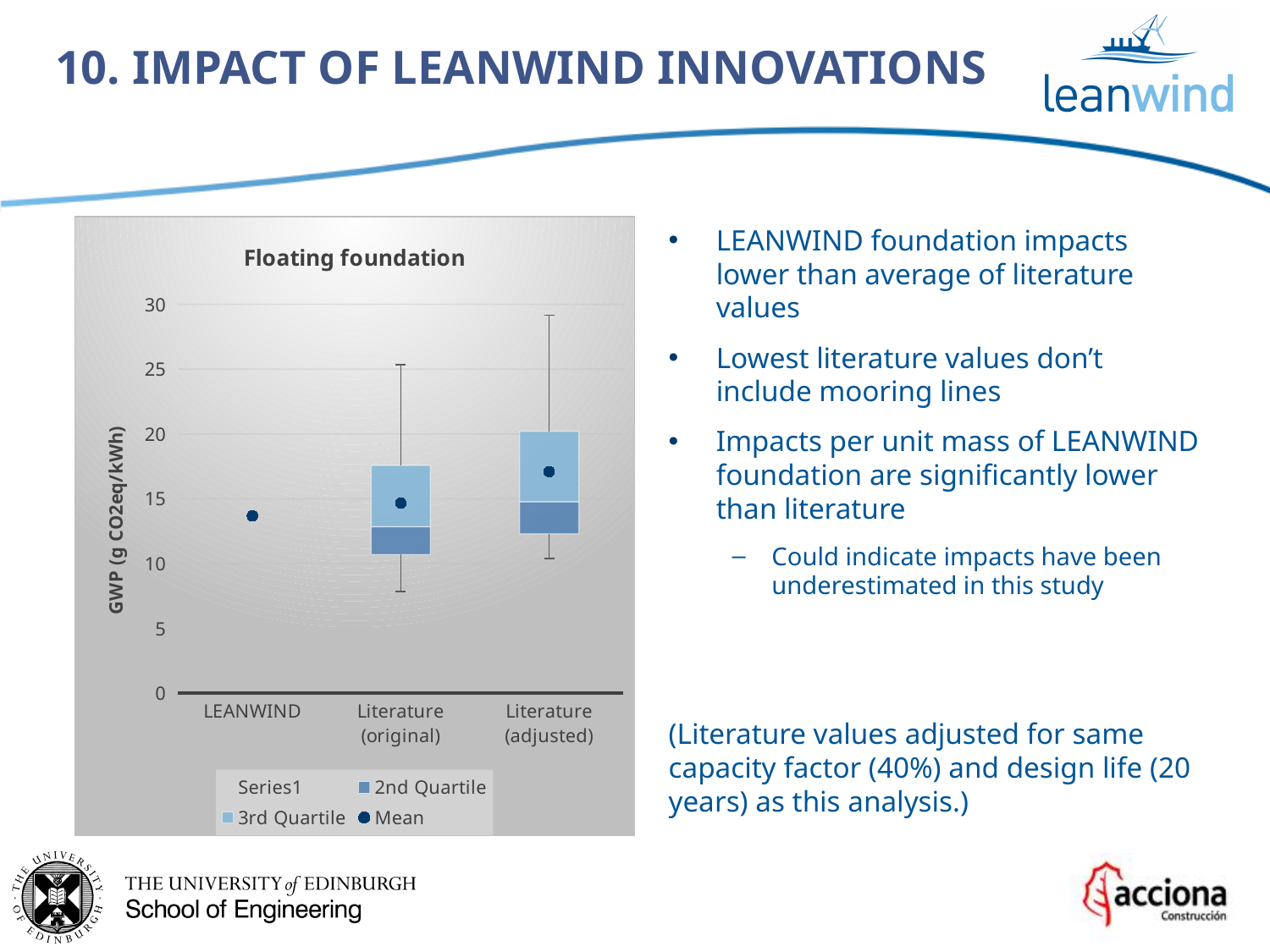
Is the top of the upper whisker for Literature (adjusted) greater or less than 25? greater Which category has the highest mean value in the chart? Literature (adjusted) How many categories are shown on the x axis of the chart? 3 What is the title of the chart? Floating foundation Is the mean value for Literature (adjusted) greater or less than 15? greater Is the mean value for LEANWIND greater or less than 15? less Which has the larger mean value, LEANWIND or Literature (adjusted)? Literature (adjusted) Which category has the lowest mean value in the chart? LEANWIND How many entries does the chart's legend list? 4 What is the label on the vertical axis of the chart? GWP (g CO2eq/kWh)